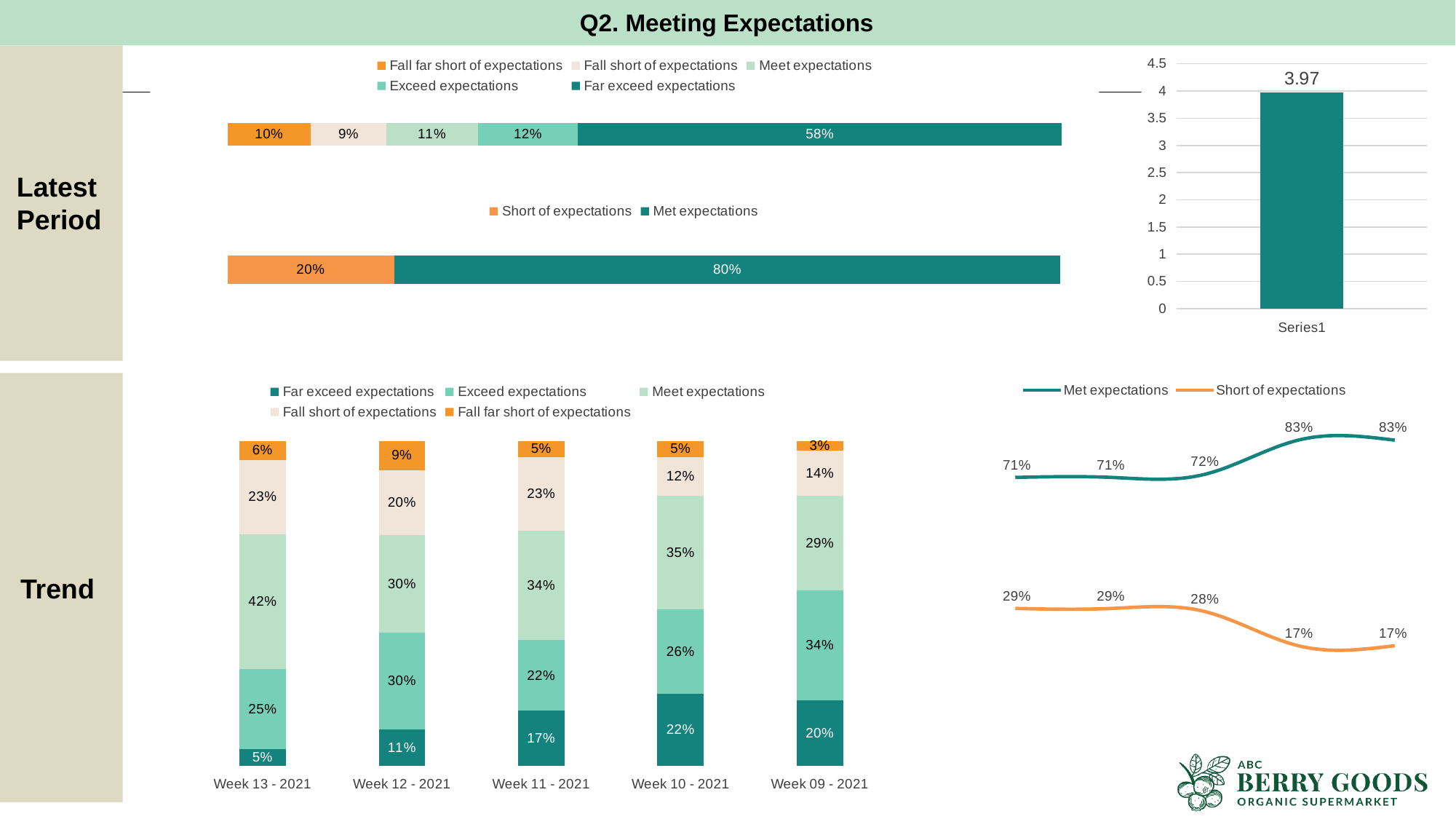
In the stacked bar chart in the Trend section, how many weeks are shown on the x axis? 5 In the line chart in the Trend section, what is the value of Short of expectations at the third point? 28% In the two-segment stacked bar in the Latest Period section, what is the difference between Met expectations and Short of expectations? 60% In the two-segment stacked bar in the Latest Period section, what is the value for Met expectations? 80% What kind of chart is shown at the bottom right of the slide in the Trend section? line chart In the bar chart at the top right of the slide, is the value for Series1 greater or less than 3.5? greater In the stacked bar chart in the Trend section, what is the value for Far exceed expectations in Week 10 - 2021? 22% In the stacked bar chart in the Trend section, which week has the highest value for Meet expectations? Week 13 - 2021 In the top-left five-segment stacked bar in the Latest Period section, what is the value for Fall far short of expectations? 10% In the stacked bar chart in the Trend section, how many series does the legend list? 5 In the bar chart at the top right of the slide, what value is shown for Series1? 3.97 In the top-left five-segment stacked bar in the Latest Period section, what is the value for Far exceed expectations? 58%